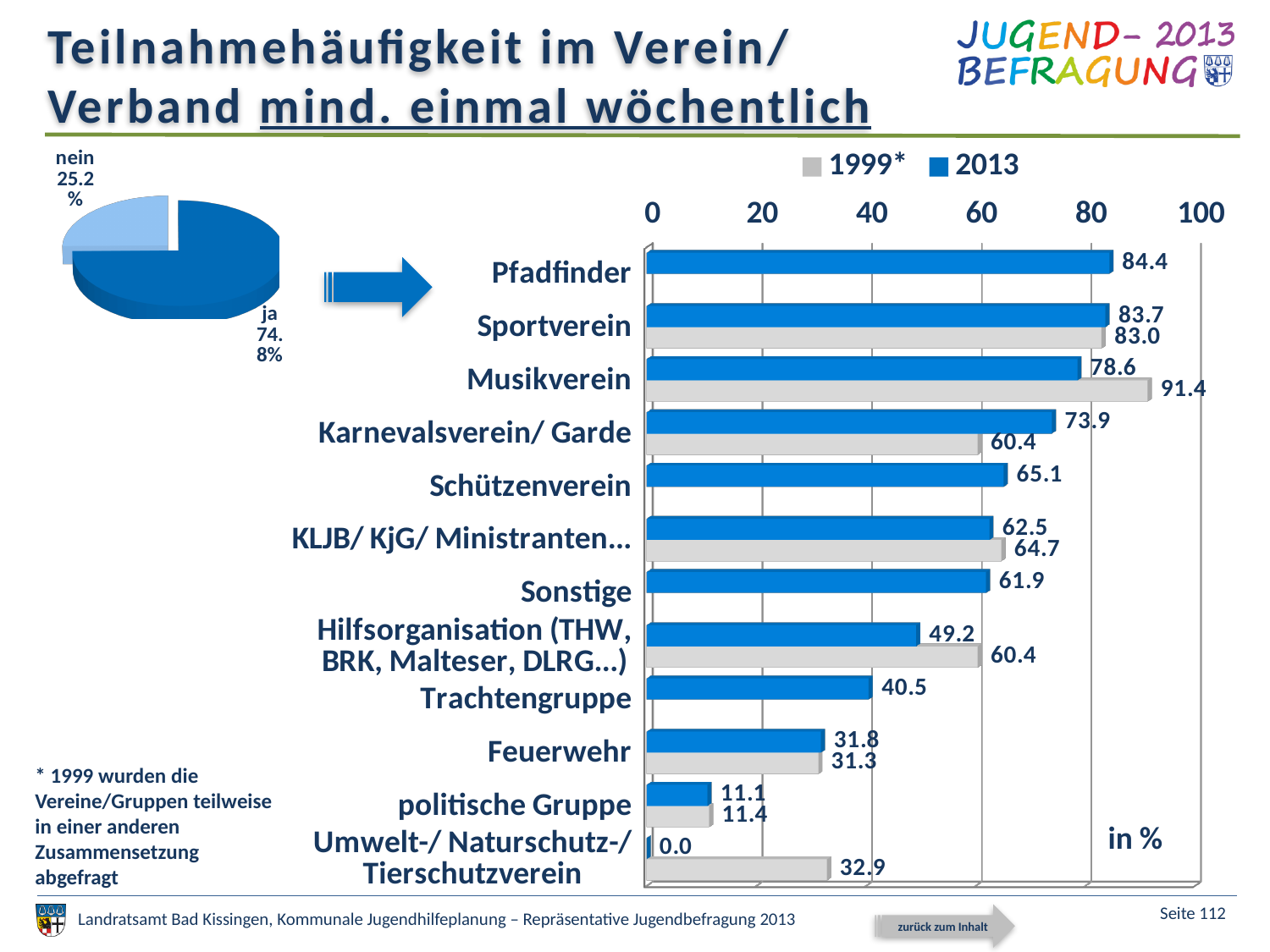
In the bar chart, which category has the highest 2013 value? Pfadfinder In the pie chart, what share is labelled 'ja'? 74.8% In the pie chart, what share is labelled 'nein'? 25.2 % In the bar chart, which category has the lowest 2013 value? Umwelt-/ Naturschutz-/ Tierschutzverein In the bar chart, what is the 2013 value for Pfadfinder? 84.4 In the bar chart, which is larger for Karnevalsverein/ Garde: the 1999* value or the 2013 value? 2013 In the bar chart, what is the 2013 value for Hilfsorganisation (THW, BRK, Malteser, DLRG...)? 49.2 In the bar chart, how many categories are shown? 12 In the bar chart, how many series does the legend list? 2 What kind of chart is the chart on the right side of the slide? bar chart In the bar chart, what is the 1999* value for Musikverein? 91.4 In the bar chart, what is the difference between the 1999* and 2013 values for Musikverein? 12.8